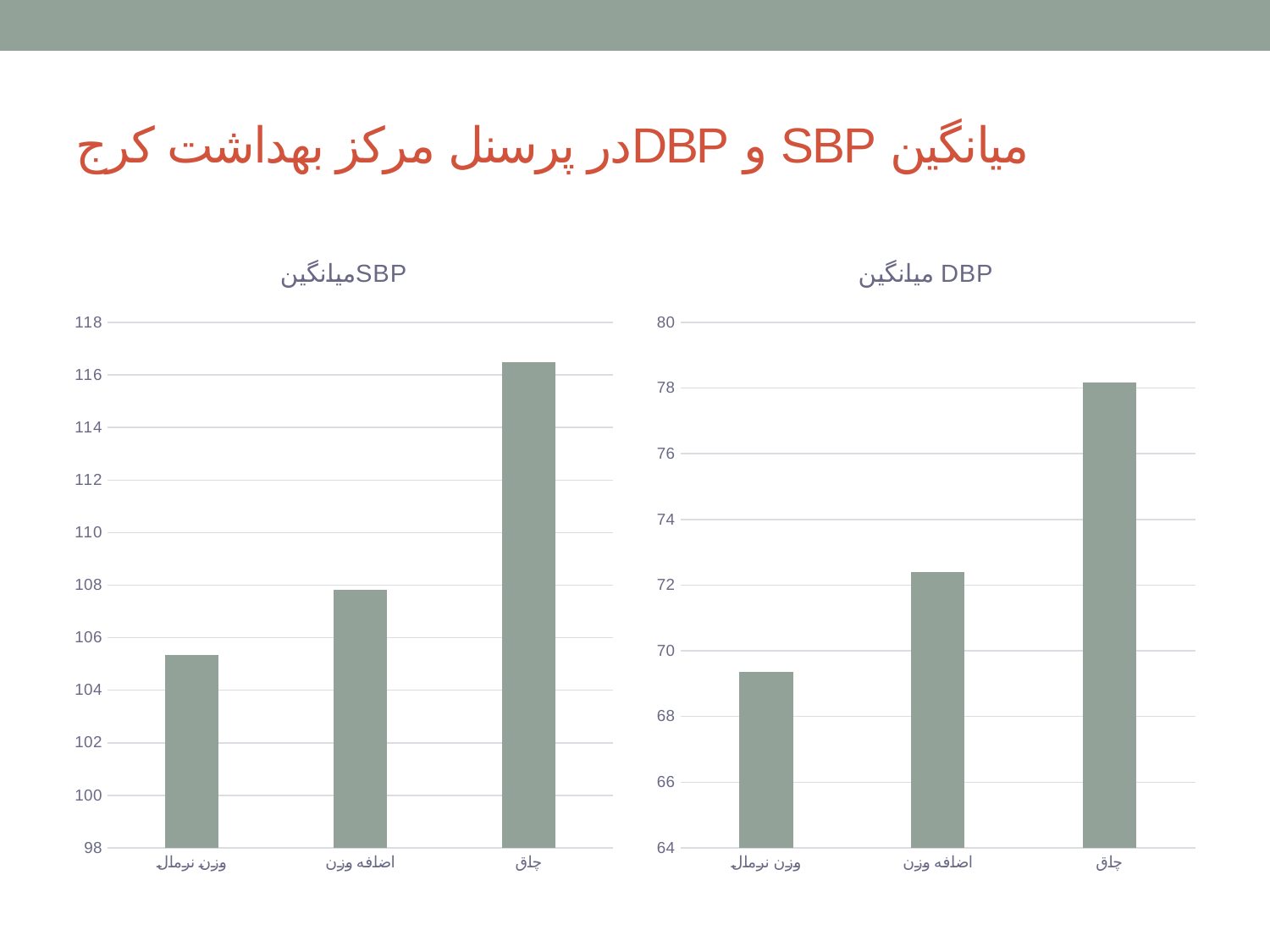
In the میانگین DBP chart, which category has the lowest value? وزن نرمال In the میانگین DBP chart, which is larger, the value for اضافه وزن or the value for وزن نرمال? اضافه وزن In the میانگین SBP chart, which category has the lowest value? وزن نرمال What kind of chart is the میانگین DBP chart? bar chart How many categories are shown in the میانگین SBP chart? 3 In the میانگین SBP chart, which category has the highest value? چاق In the میانگین DBP chart, which category has the highest value? چاق In the میانگین SBP chart, is the value for وزن نرمال greater or less than 104? greater In the میانگین SBP chart, do the values rise or fall from وزن نرمال to چاق? rise In the میانگین SBP chart, is the value for چاق greater or less than 114? greater In the میانگین DBP chart, is the value for وزن نرمال greater or less than 70? less